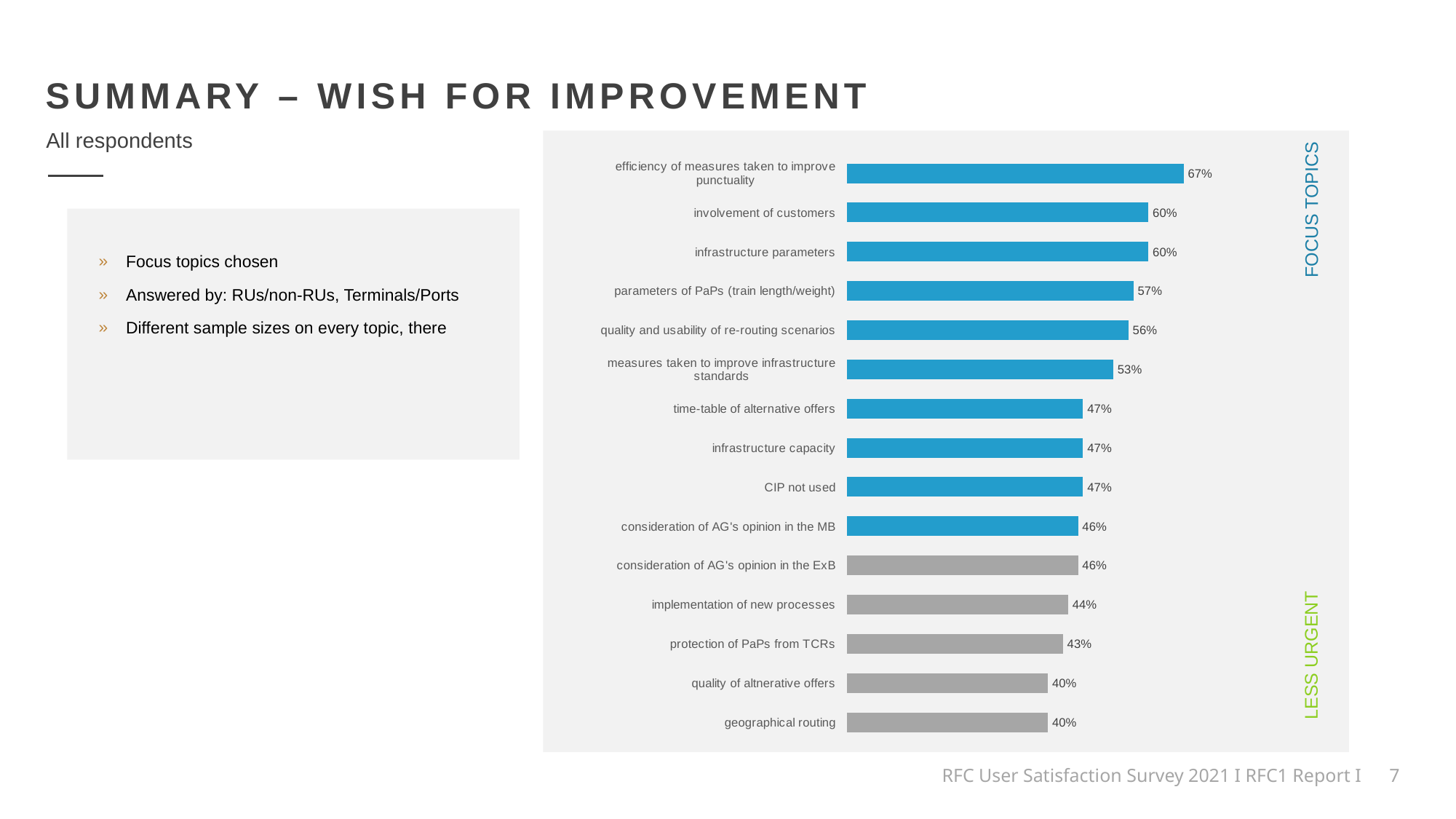
How many categories are shown in the chart? 15 Which category has the highest value? efficiency of measures taken to improve punctuality How many bars are coloured grey (the 'LESS URGENT' group)? 5 What is the lowest value shown in the chart? 40% Which is larger, 'measures taken to improve infrastructure standards' or 'implementation of new processes'? measures taken to improve infrastructure standards What is the value for 'quality and usability of re-routing scenarios'? 56% What is the value for 'protection of PaPs from TCRs'? 43% What is the difference between 'efficiency of measures taken to improve punctuality' and 'geographical routing'? 27% What is the difference between 'involvement of customers' and 'parameters of PaPs (train length/weight)'? 3% What is the value for 'efficiency of measures taken to improve punctuality'? 67% What label is shown vertically next to the blue bars at the top right of the chart? FOCUS TOPICS What kind of chart is shown on the slide? bar chart